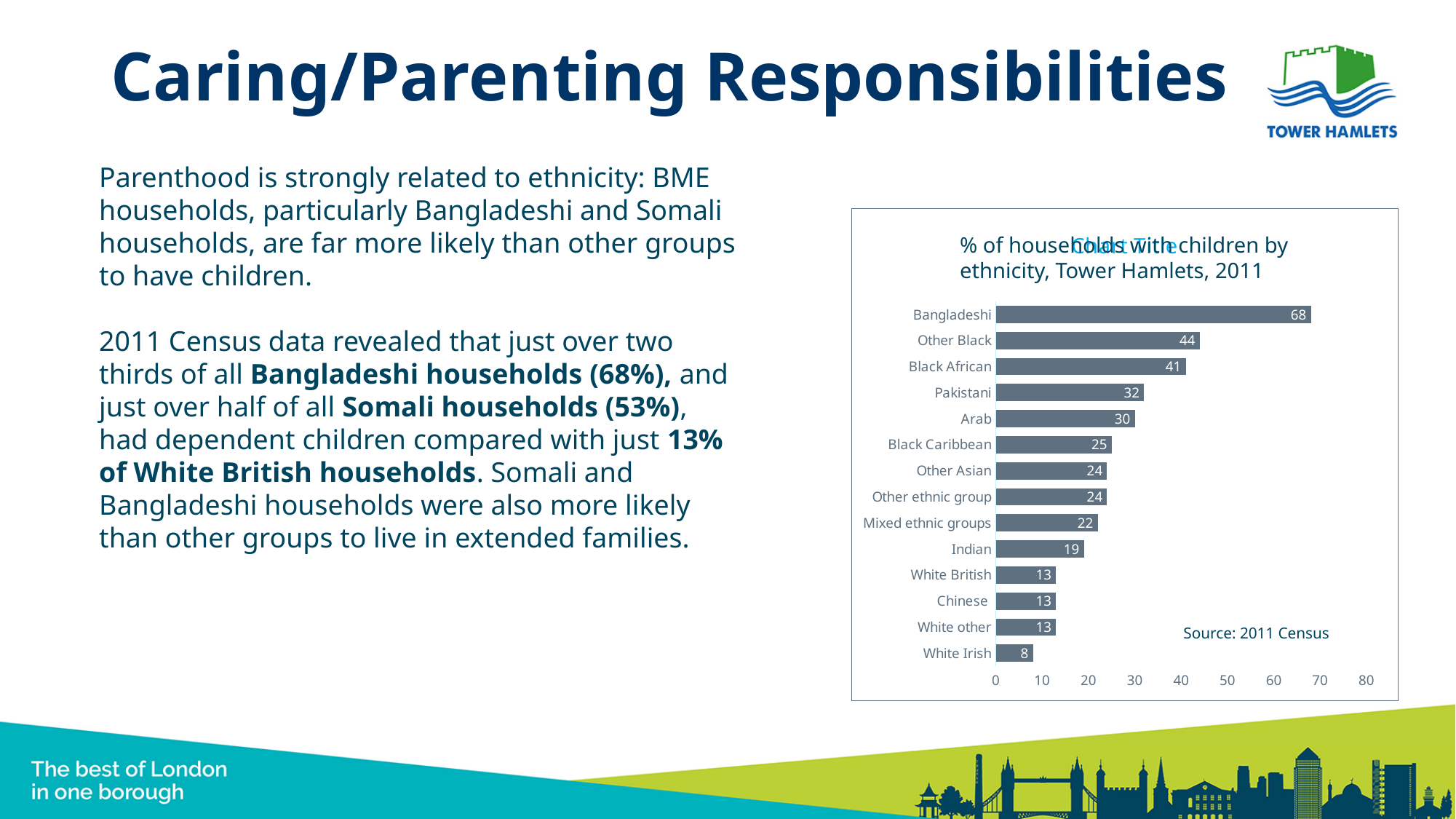
What is the value for Indian households in the chart? 19 What is the source cited in the chart? 2011 Census Which ethnic group has the lowest percentage of households with children? White Irish What is the value for Bangladeshi households in the chart? 68 Which ethnic group has the highest percentage of households with children? Bangladeshi What is the difference between the values for Bangladeshi and White British households? 55 Which is larger, the value for Arab or the value for Black Caribbean? Arab Is the value for Other Black greater or less than 40? greater What is the value for Pakistani households in the chart? 32 How many ethnic groups are shown in the chart? 14 What is the difference between the values for Other Black and Black African households? 3 What kind of chart is shown on the slide? Bar chart